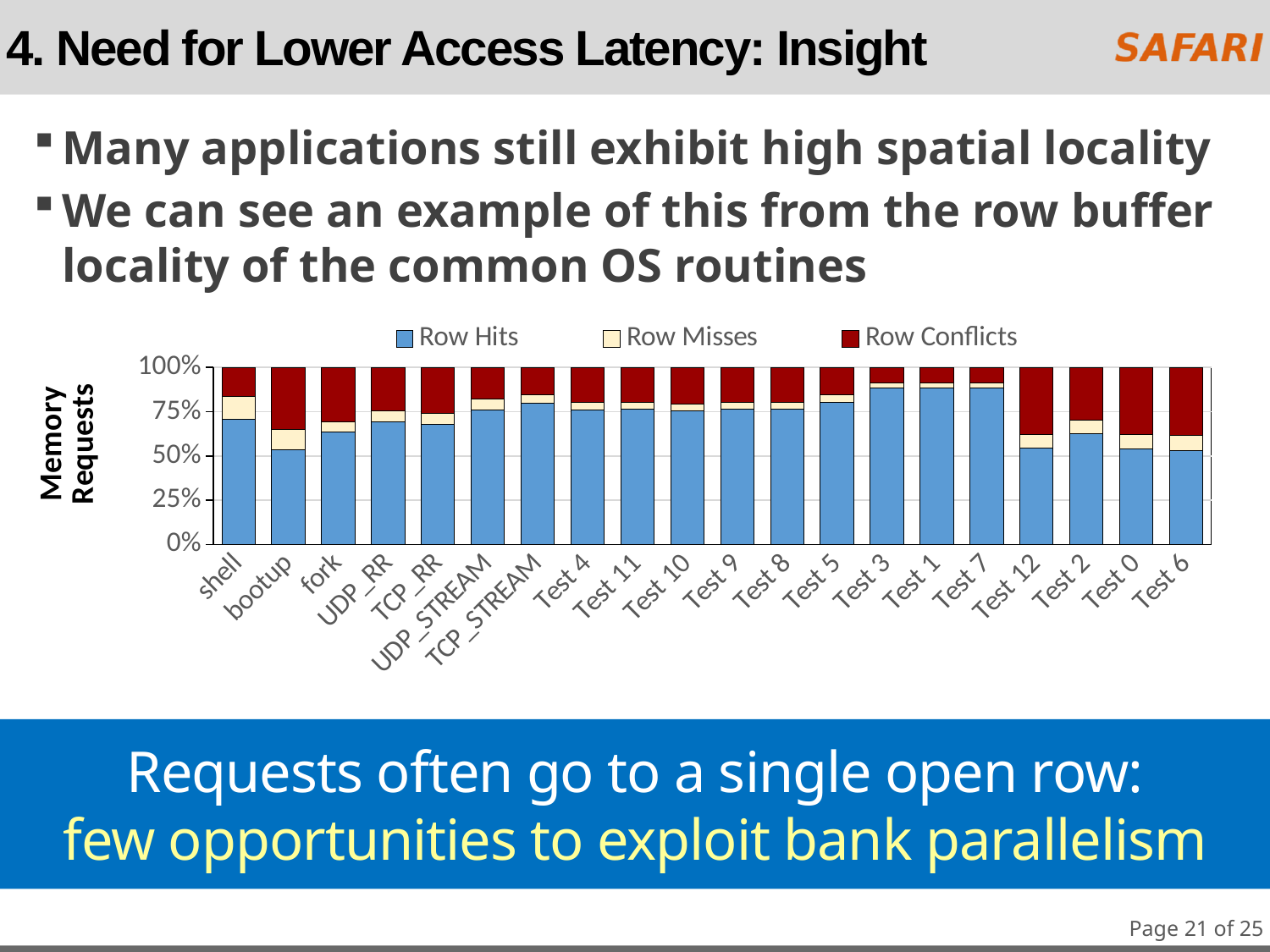
Which has a larger Row Hits share, Test 3 or shell? Test 3 How many series does the chart's legend list? 3 Which has a larger Row Hits share, TCP_STREAM or bootup? TCP_STREAM What is the label on the chart's y axis? Memory Requests Is the Row Hits value for fork greater or less than 50%? greater How many categories are shown along the x axis of the chart? 20 Is the Row Hits value for shell greater or less than 75%? less What are the three series named in the chart's legend? Row Hits, Row Misses, Row Conflicts What kind of chart is shown on the slide? stacked bar chart Is the Row Hits value for Test 3 greater or less than 75%? greater What is the total height of the stacked bar for shell? 100%